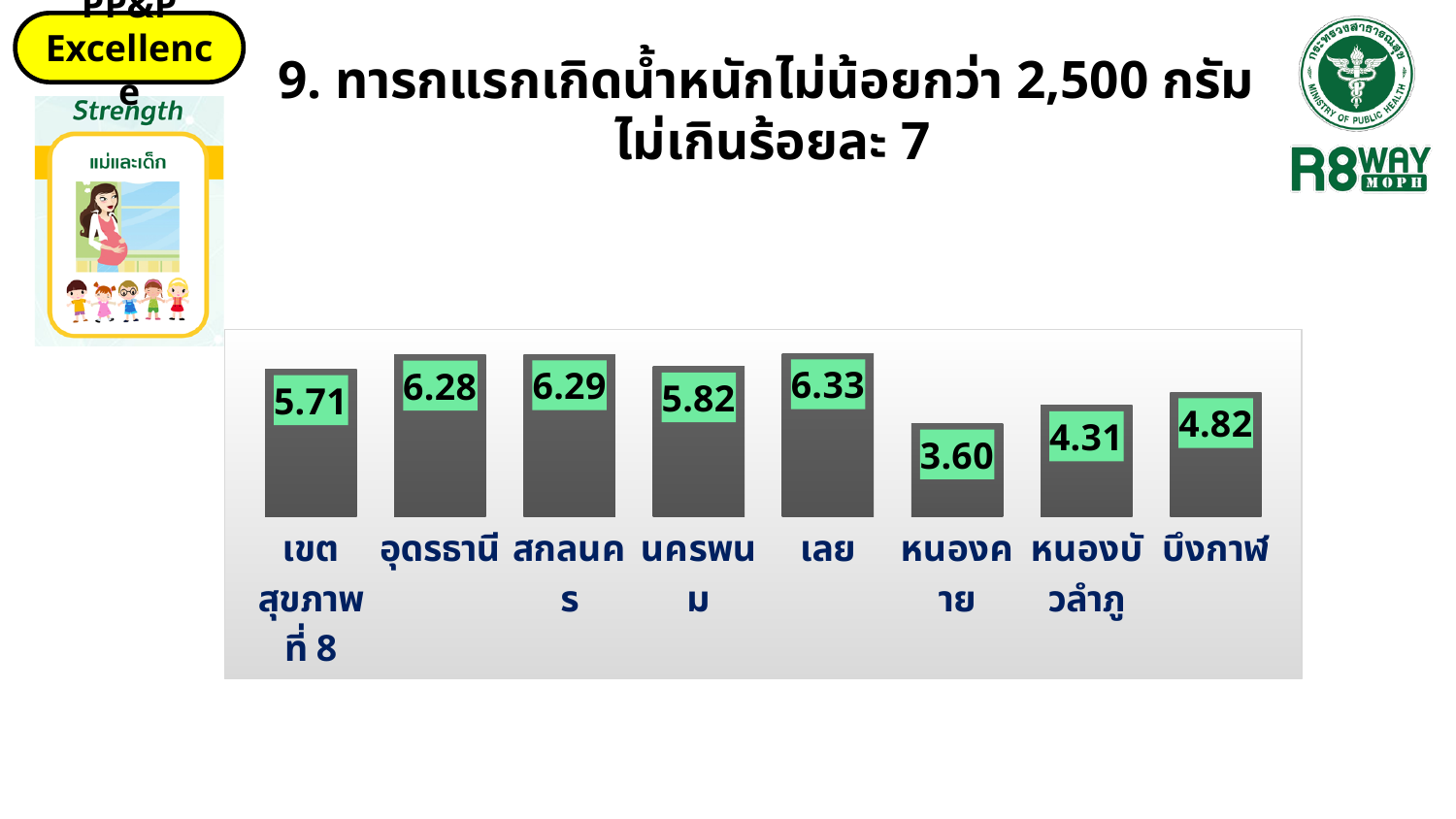
Which category has the highest value? เลย What is the value for หนองคาย? 3.60 What is the value for บึงกาฬ? 4.82 Which is larger, the value for สกลนคร or the value for บึงกาฬ? สกลนคร How many categories are shown in the chart? 8 What is the difference between the values for อุดรธานี and หนองบัวลำภู? 1.97 What is the value for เขตสุขภาพที่ 8? 5.71 What kind of chart is shown on the slide? bar chart What is the value for นครพนม? 5.82 Which category has the lowest value? หนองคาย What is the difference between the values for เลย and หนองคาย? 2.73 What is the value for หนองบัวลำภู? 4.31